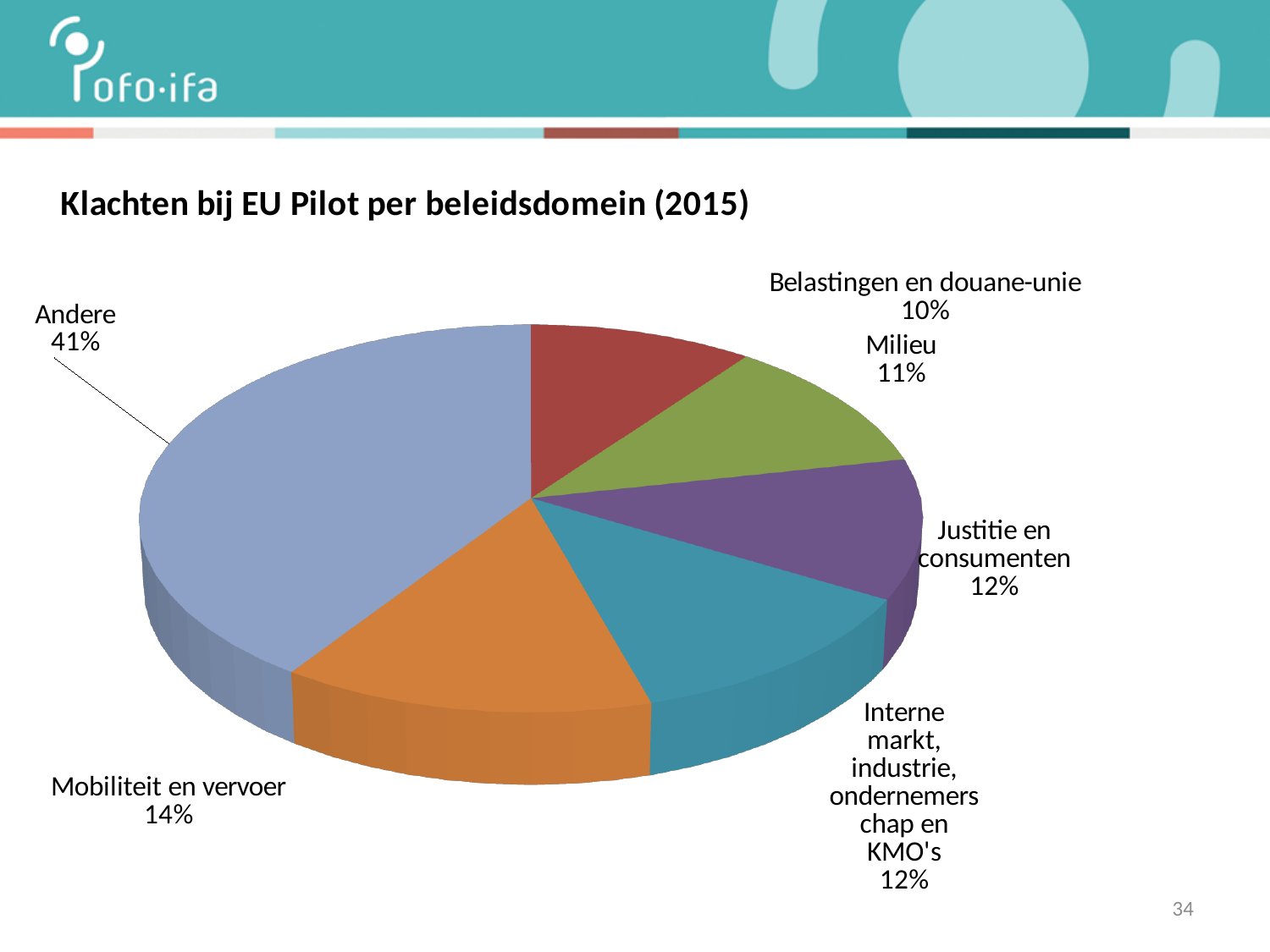
Which category has the smallest slice of the pie? Belastingen en douane-unie Which is larger, the share for Milieu or the share for Mobiliteit en vervoer? Mobiliteit en vervoer Which category has the largest slice of the pie? Andere What is the difference in percentage points between Andere and Mobiliteit en vervoer? 27% What percentage is shown for Belastingen en douane-unie? 10% What percentage is shown for Milieu? 11% What share of the pie does Andere represent? 41% What kind of chart is shown on the slide? Pie chart What percentage is shown for Mobiliteit en vervoer? 14% What is the title of the chart? Klachten bij EU Pilot per beleidsdomein (2015) What percentage is shown for Justitie en consumenten? 12% How many categories are shown in the pie chart? 6